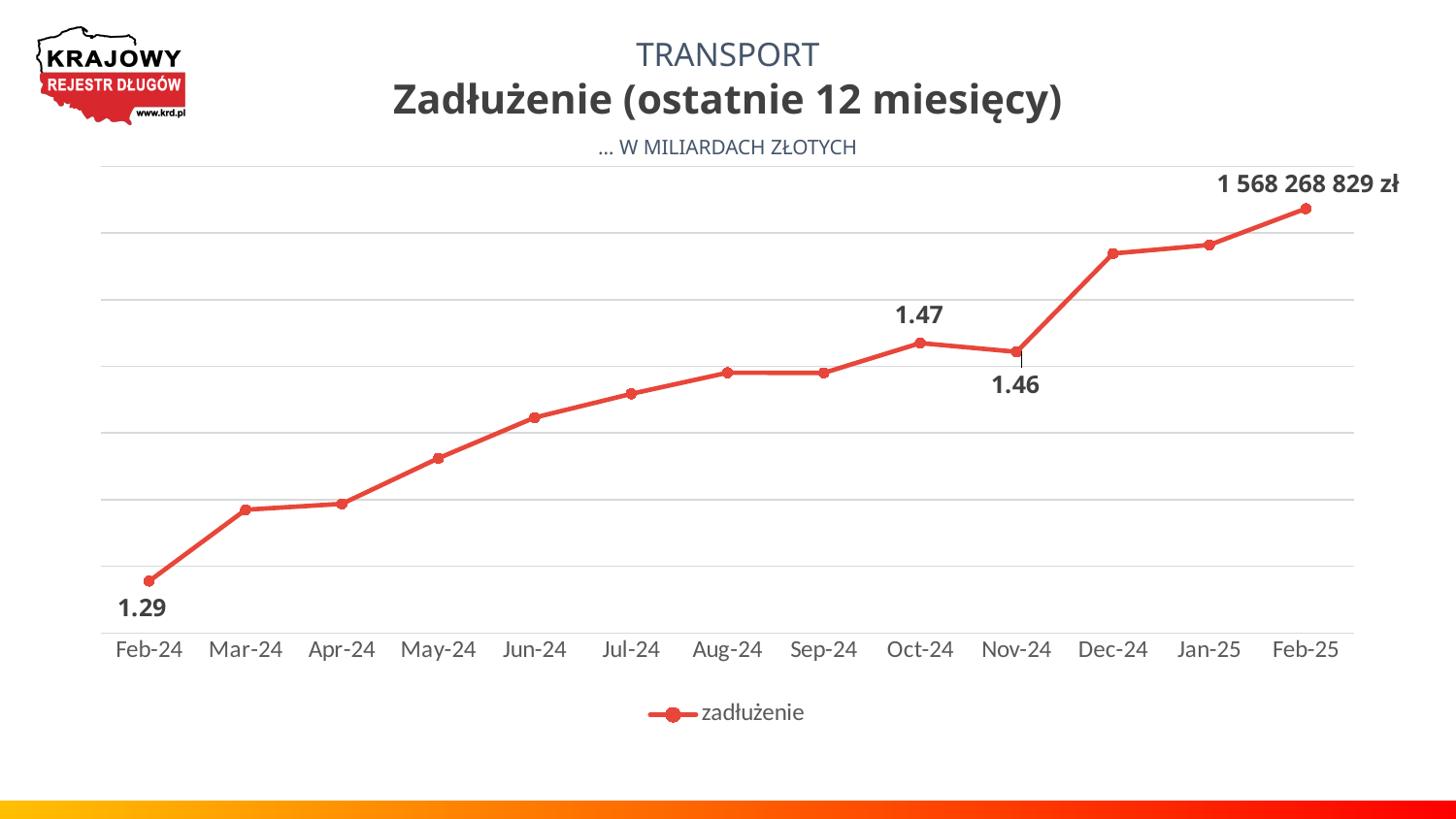
Which is larger, the value for Dec-24 or the value for Sep-24? Dec-24 How many months are plotted on the x axis? 13 What is the value for Oct-24? 1.47 How many series does the legend list? 1 What kind of chart is shown? line chart Which month has the highest value? Feb-25 Do the values generally rise or fall from Feb-24 to Feb-25? rise Which month has the lowest value? Feb-24 What is the value for Nov-24? 1.46 What is the difference between the values for Oct-24 and Nov-24? 0.01 What is the value for Feb-24? 1.29 What value is labelled at Feb-25? 1 568 268 829 zł